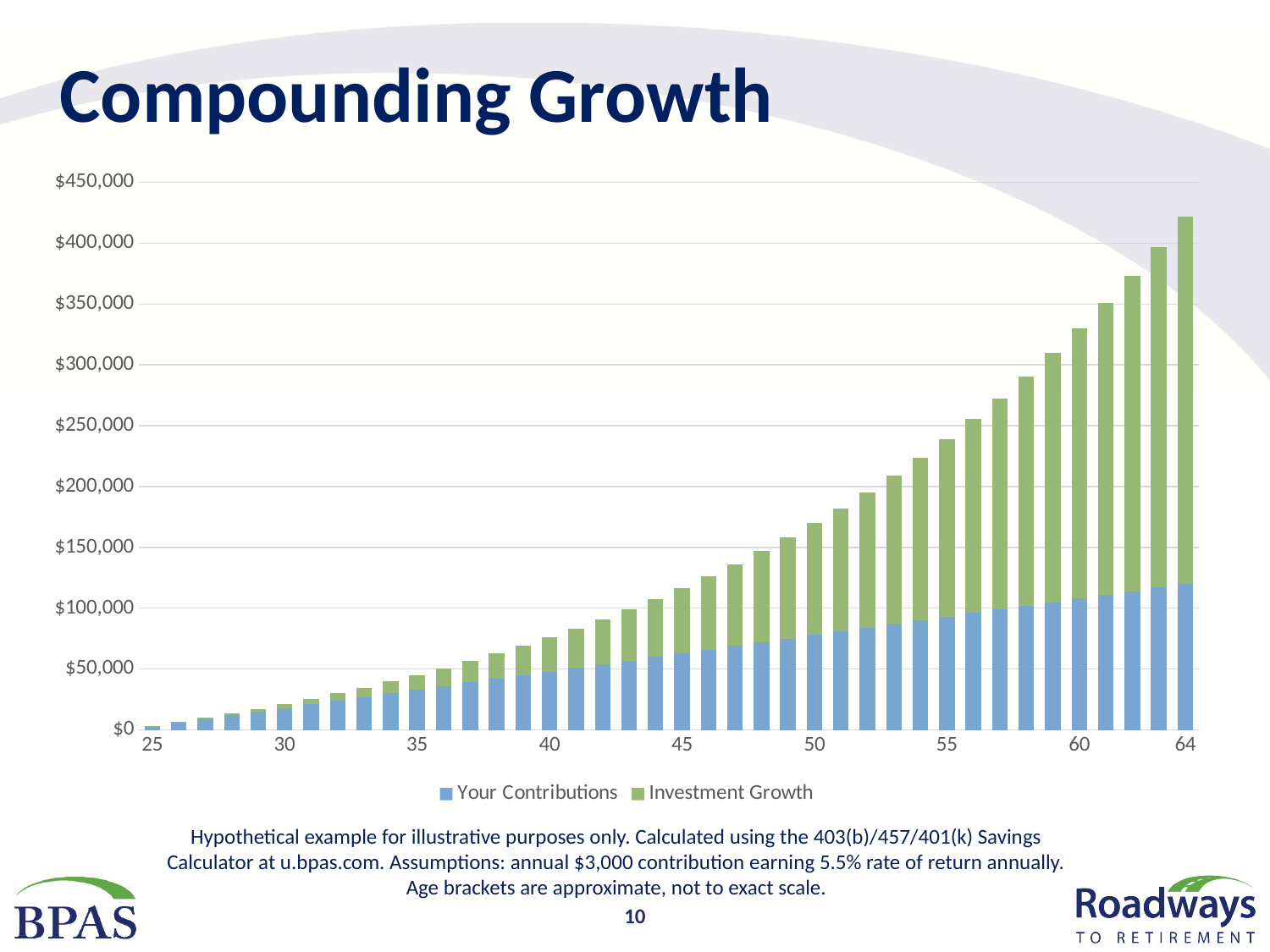
Do the total bar heights rise or fall as age increases along the x axis? Rise What kind of chart is shown on the slide? Stacked bar chart How many series does the legend list? 2 Is the total value at age 40 greater or less than $100,000? less How many bars (ages) are plotted on the chart? 40 What is the title of the chart? Compounding Growth Is the Your Contributions value at age 64 greater or less than $100,000? greater What are the two series named in the legend? Your Contributions and Investment Growth At which age is the total bar the tallest? 64 At which age is the total bar the shortest? 25 Is the total value at age 64 greater or less than $400,000? greater